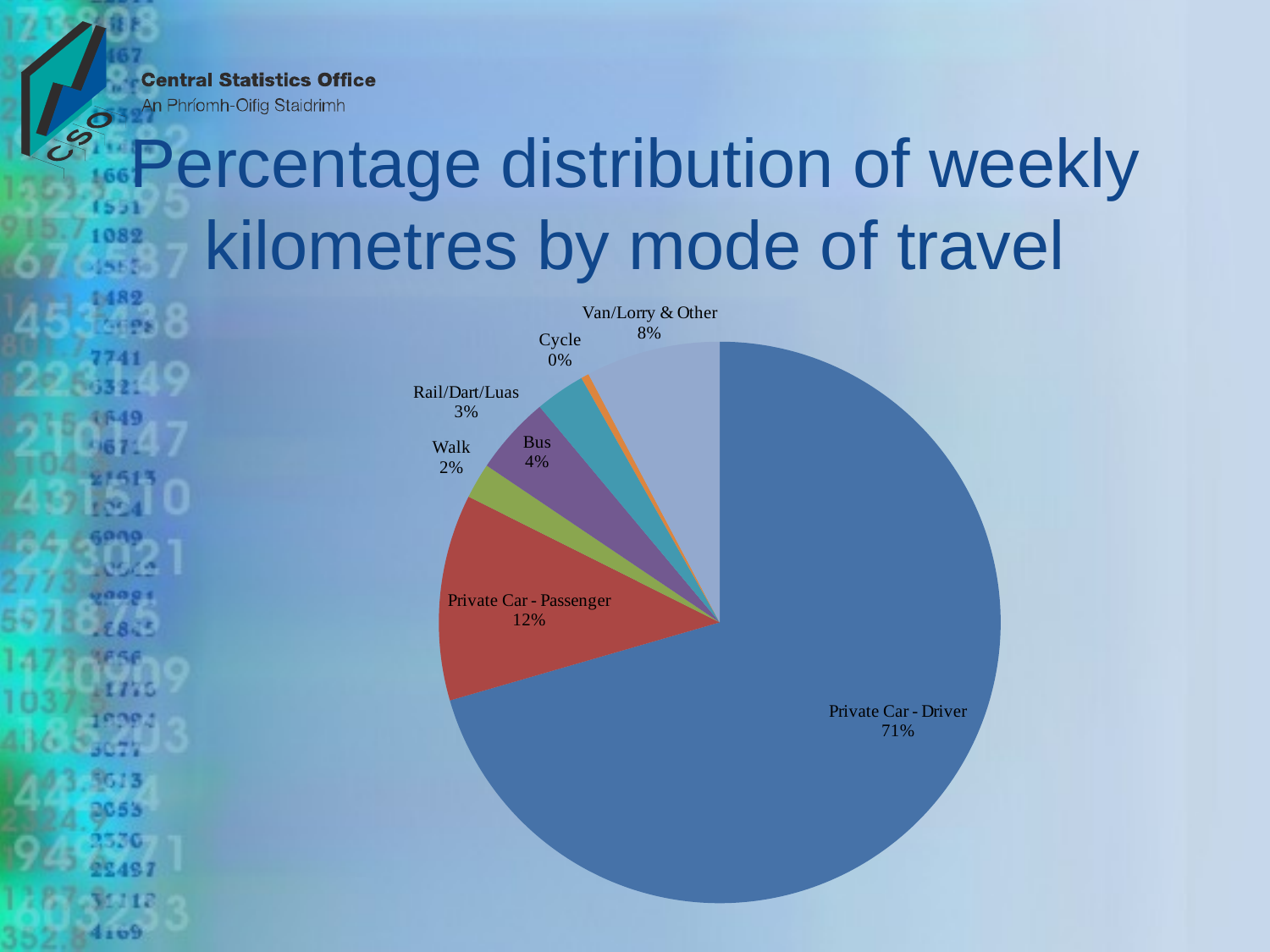
Which mode of travel has the largest share of weekly kilometres? Private Car - Driver How many modes of travel are shown in the pie chart? 7 What percentage of weekly kilometres is attributed to Private Car - Driver? 71% What share of weekly kilometres does Private Car - Passenger account for? 12% Which mode of travel has the smallest share of weekly kilometres? Cycle What percentage is shown for Cycle? 0% What is the difference in percentage points between Private Car - Driver and Private Car - Passenger? 59 What percentage is shown for Rail/Dart/Luas? 3% Which has a larger share, Bus or Walk? Bus What percentage is shown for Bus? 4% What type of chart is shown on the slide? Pie chart What percentage is shown for Van/Lorry & Other? 8%